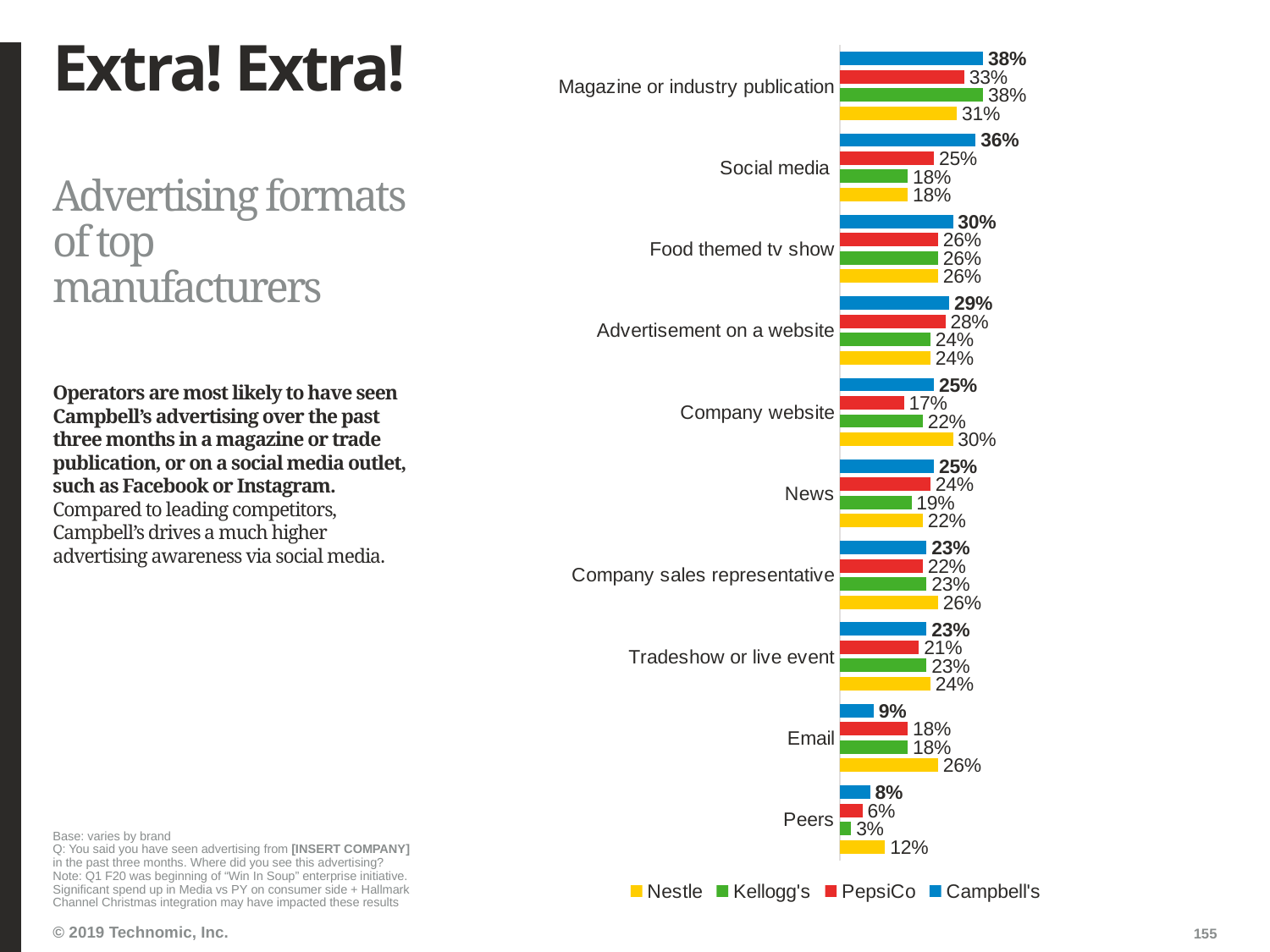
What is the value for Nestle for Company website? 30% What kind of chart is shown on the slide? Bar chart For Email, which is larger: the value for Campbell's or the value for Nestle? Nestle How many advertising format categories are shown in the chart? 10 What is the value for PepsiCo for Email? 18% What is the value for Campbell's for Social media? 36% Which series is shown in yellow in the legend? Nestle What is the value for Kellogg's for Peers? 3% Which category has the lowest value for Campbell's? Peers Which category has the highest value for Nestle? Magazine or industry publication How many series does the legend list? 4 What is the difference between Campbell's and Kellogg's for Social media? 18%